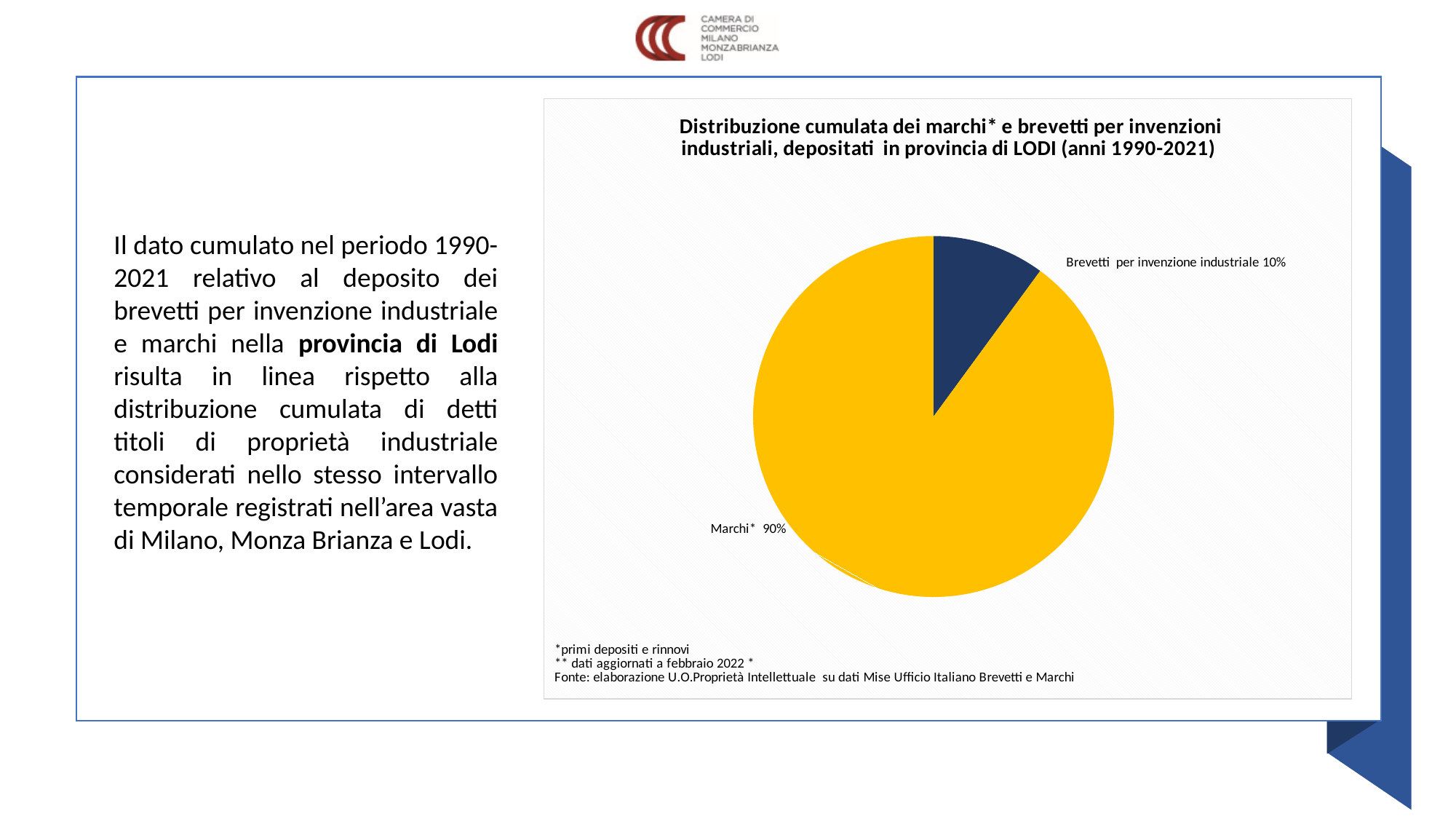
How many slices does the pie chart have? 2 Which category has the smallest slice of the pie? Brevetti per invenzione industriale Which is larger, the share for Marchi* or the share for Brevetti per invenzione industriale? Marchi* What colour is the Marchi* slice of the pie? Yellow What is the difference in percentage points between the Marchi* share and the Brevetti per invenzione industriale share? 80 What share of the pie does Marchi* represent? 90% Which province does the chart title say the data refers to? LODI What kind of chart is shown on the slide? Pie chart Which category has the largest slice of the pie? Marchi* What share of the pie does Brevetti per invenzione industriale represent? 10%